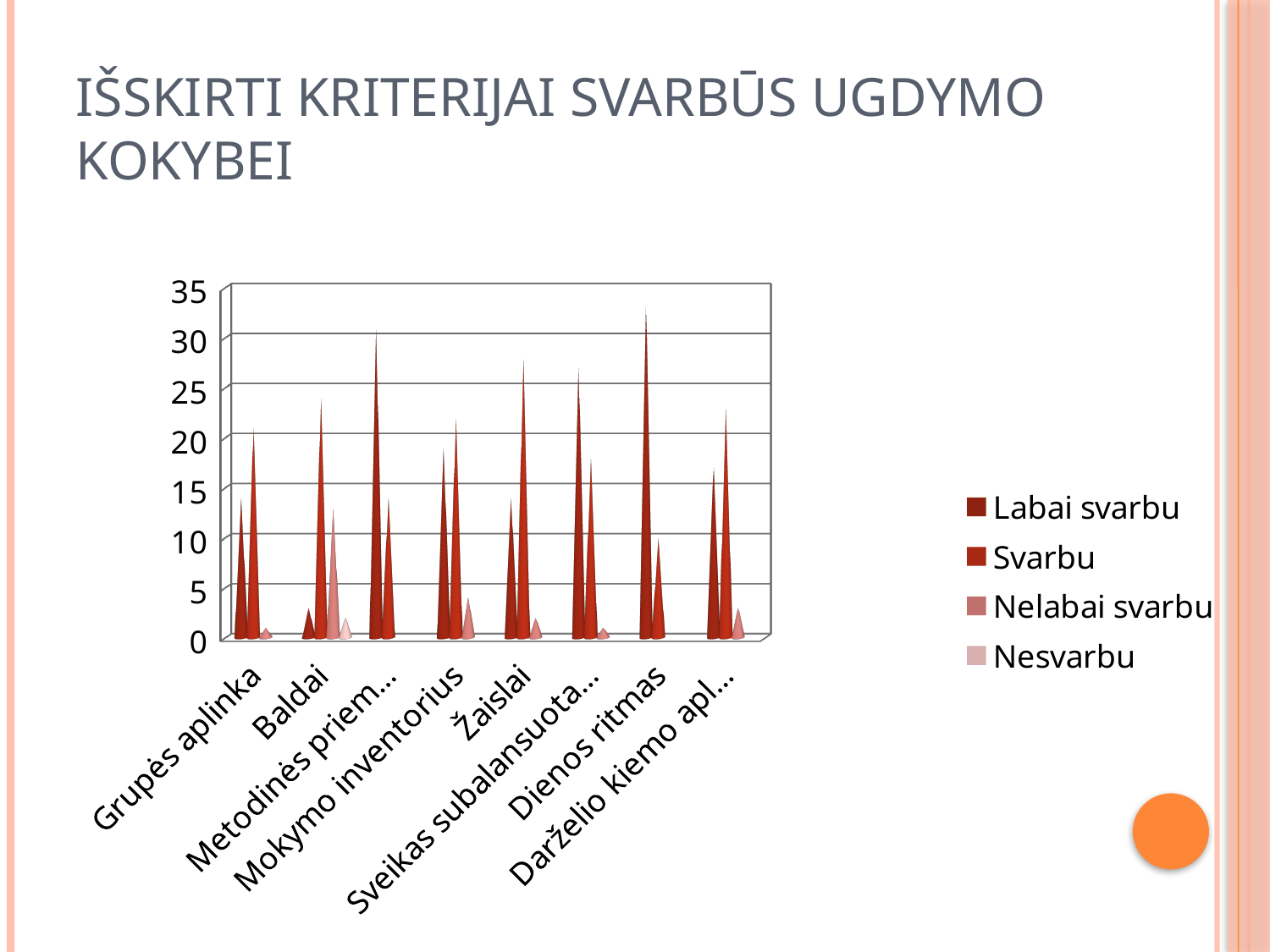
What kind of chart is shown on the slide? bar chart Is the 'Svarbu' value for Grupės aplinka greater or less than 15? greater For Grupės aplinka, which is larger: the 'Labai svarbu' value or the 'Svarbu' value? Svarbu What is the title of the slide containing the chart? IŠSKIRTI KRITERIJAI SVARBŪS UGDYMO KOKYBEI Is the 'Labai svarbu' value for Dienos ritmas greater or less than 25? greater How many series does the chart legend list? 4 Which series is listed first in the chart legend? Labai svarbu For Metodinės priem..., which is larger: the 'Labai svarbu' value or the 'Svarbu' value? Labai svarbu Is the 'Labai svarbu' value for Baldai greater or less than 5? less How many categories are shown on the x axis of the chart? 8 Which category has the lowest 'Labai svarbu' value? Baldai